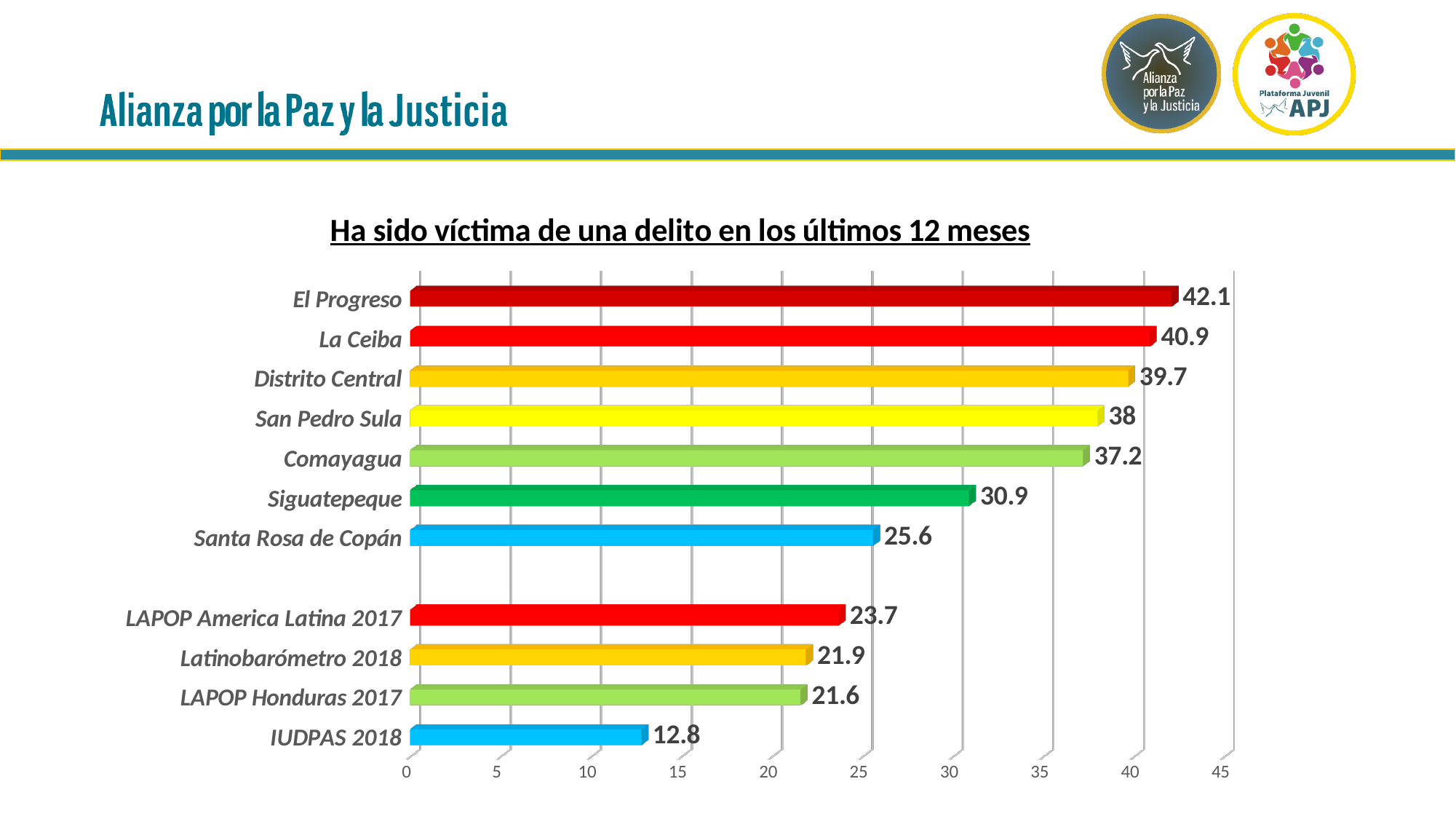
How many categories are plotted in the chart? 11 Which category has the lowest value? IUDPAS 2018 Which is larger, the value for San Pedro Sula or the value for Comayagua? San Pedro Sula What is the difference between the values for El Progreso and La Ceiba? 1.2 Which is larger, the value for LAPOP America Latina 2017 or the value for Latinobarómetro 2018? LAPOP America Latina 2017 What is the value for IUDPAS 2018? 12.8 What kind of chart is shown on the slide? Bar chart What is the value for El Progreso? 42.1 Which category has the highest value? El Progreso What is the value for Santa Rosa de Copán? 25.6 What is the difference between the values for Comayagua and Siguatepeque? 6.3 What is the title of the chart? Ha sido víctima de una delito en los últimos 12 meses